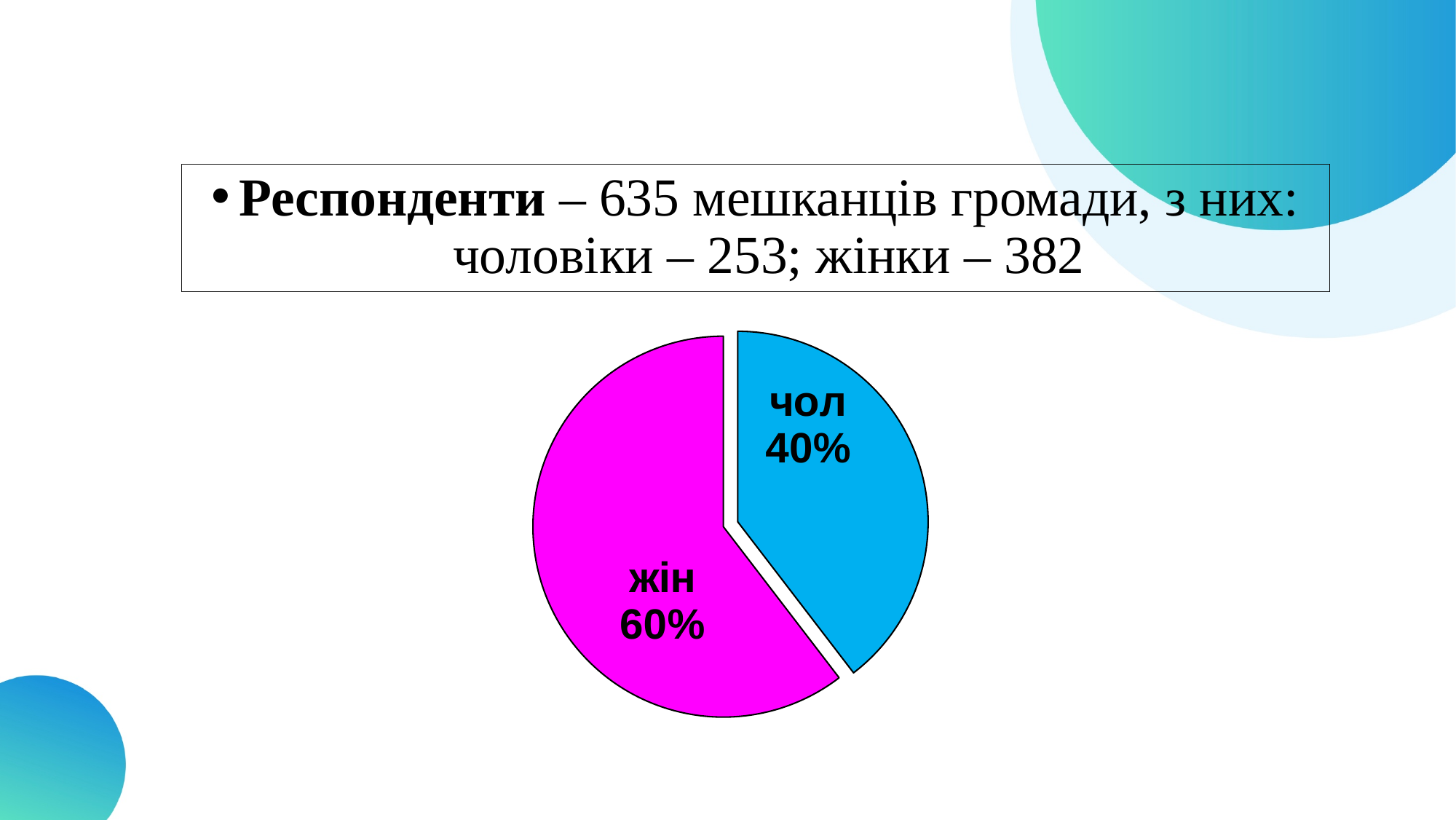
Which slice of the pie is the largest? жін What is the difference in percentage points between the "жін" and "чол" slices? 20% Which slice is larger, "чол" or "жін"? жін What colour is the "чол" slice? blue Which slice of the pie is the smallest? чол What share of the pie does the "чол" slice represent? 40% What share of the pie does the "жін" slice represent? 60% How many slices does the pie chart have? 2 What kind of chart is shown on the slide? pie chart What colour is the "жін" slice? magenta